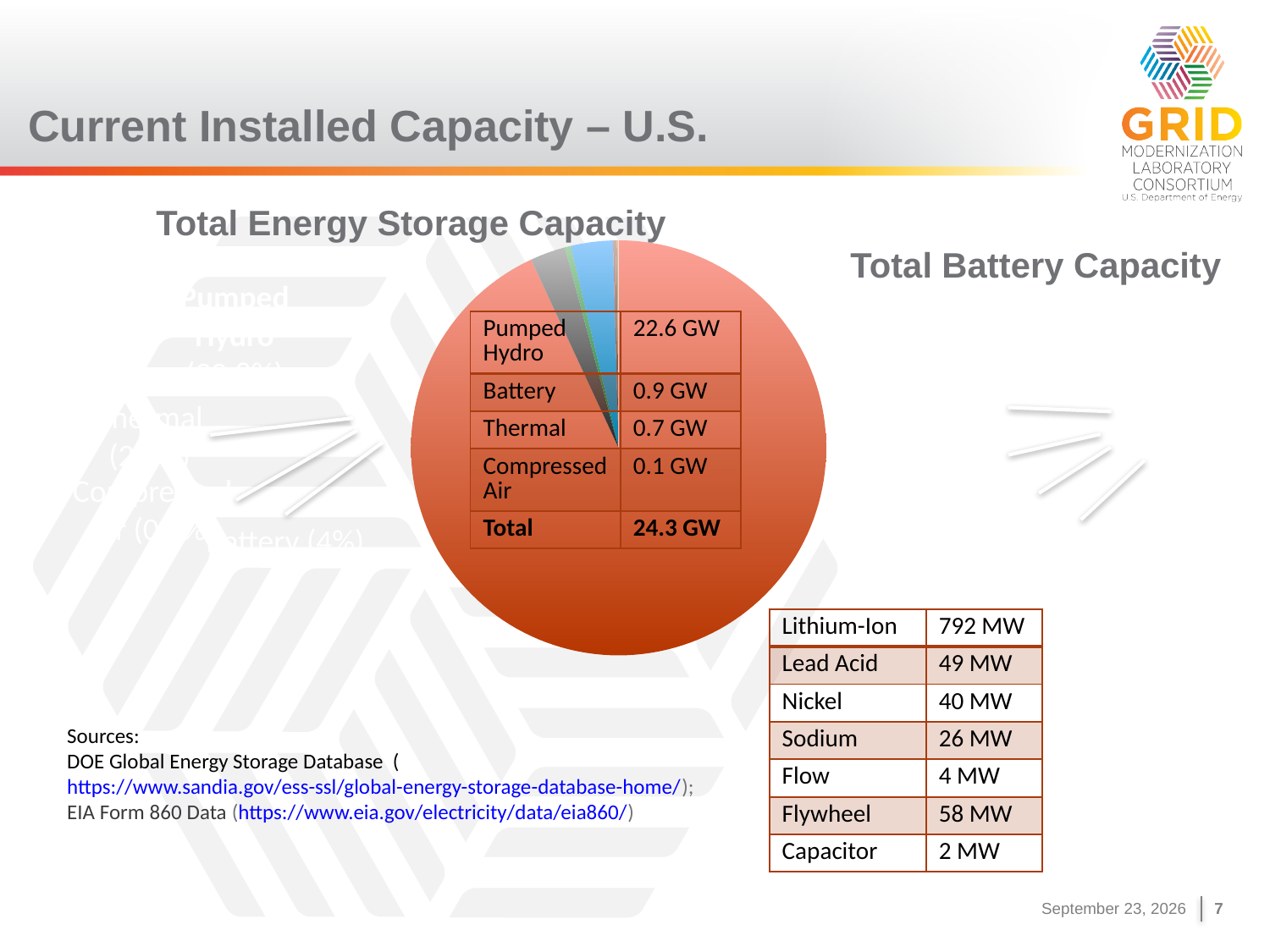
In the Total Energy Storage Capacity chart, which category has the largest capacity? Pumped Hydro What is the title of the pie chart on the left of the slide? Total Energy Storage Capacity What kind of chart is used for Total Energy Storage Capacity? pie chart In the Total Energy Storage Capacity chart, what is the total capacity across all categories? 24.3 GW In the Total Energy Storage Capacity chart, what is the value for Pumped Hydro? 22.6 GW In the Total Energy Storage Capacity chart, what is the difference between Battery and Thermal capacity? 0.2 GW In the Total Energy Storage Capacity chart, what is the value for Compressed Air? 0.1 GW In the Total Energy Storage Capacity chart, how many storage categories are shown? 4 In the Total Energy Storage Capacity chart, what is the value for Battery? 0.9 GW In the Total Energy Storage Capacity chart, which is larger, Battery or Thermal? Battery In the Total Energy Storage Capacity chart, what is the value for Thermal? 0.7 GW In the Total Energy Storage Capacity chart, which category has the smallest capacity? Compressed Air